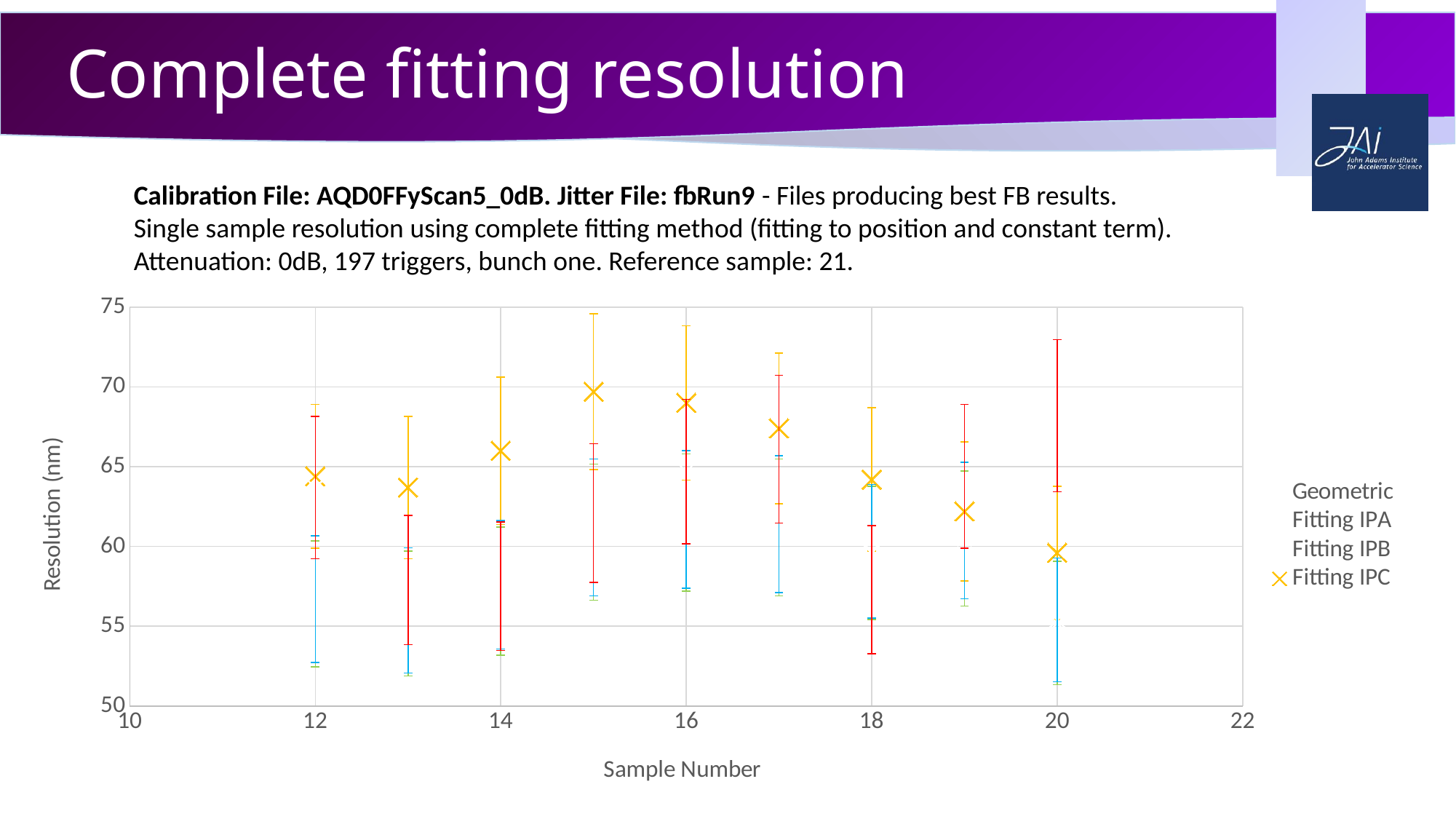
Which has the larger Fitting IPC value, sample number 17 or sample number 18? 17 Is the Fitting IPC value at sample number 15 greater or less than 65? greater At which sample number is the Fitting IPC value lowest? 20 How many series does the legend list? 4 Is the Fitting IPC value at sample number 16 greater or less than 65? greater Is the Fitting IPC value at sample number 20 greater or less than 65? less Which series is shown with yellow X markers in the legend? Fitting IPC Which has the larger Fitting IPC value, sample number 15 or sample number 20? 15 What kind of chart is shown on the slide? scatter chart How many sample numbers have Fitting IPC markers plotted? 9 What is the label of the vertical axis? Resolution (nm)